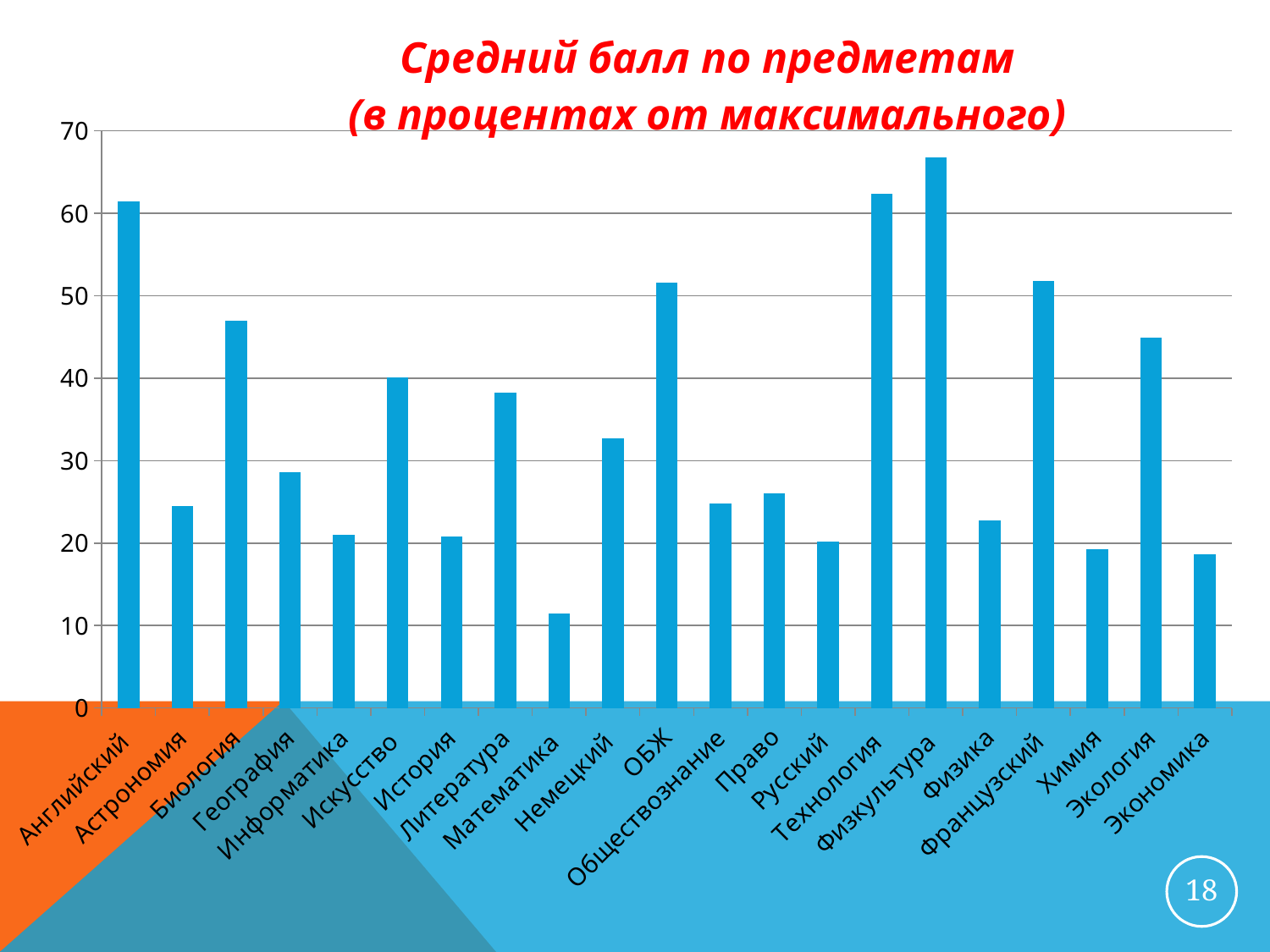
Which subject has the lowest average score? Математика Which is larger, the value for Английский or the value for Биология? Английский Is the value for Математика greater or less than 20? less Is the value for Физкультура greater or less than 60? greater Is the value for Английский greater or less than 60? greater Which subject has the highest average score? Физкультура Which is larger, the value for Немецкий or the value for Химия? Немецкий What kind of chart is shown on the slide? bar chart How many subjects are shown on the x axis? 21 What is the title of the chart? Средний балл по предметам (в процентах от максимального)